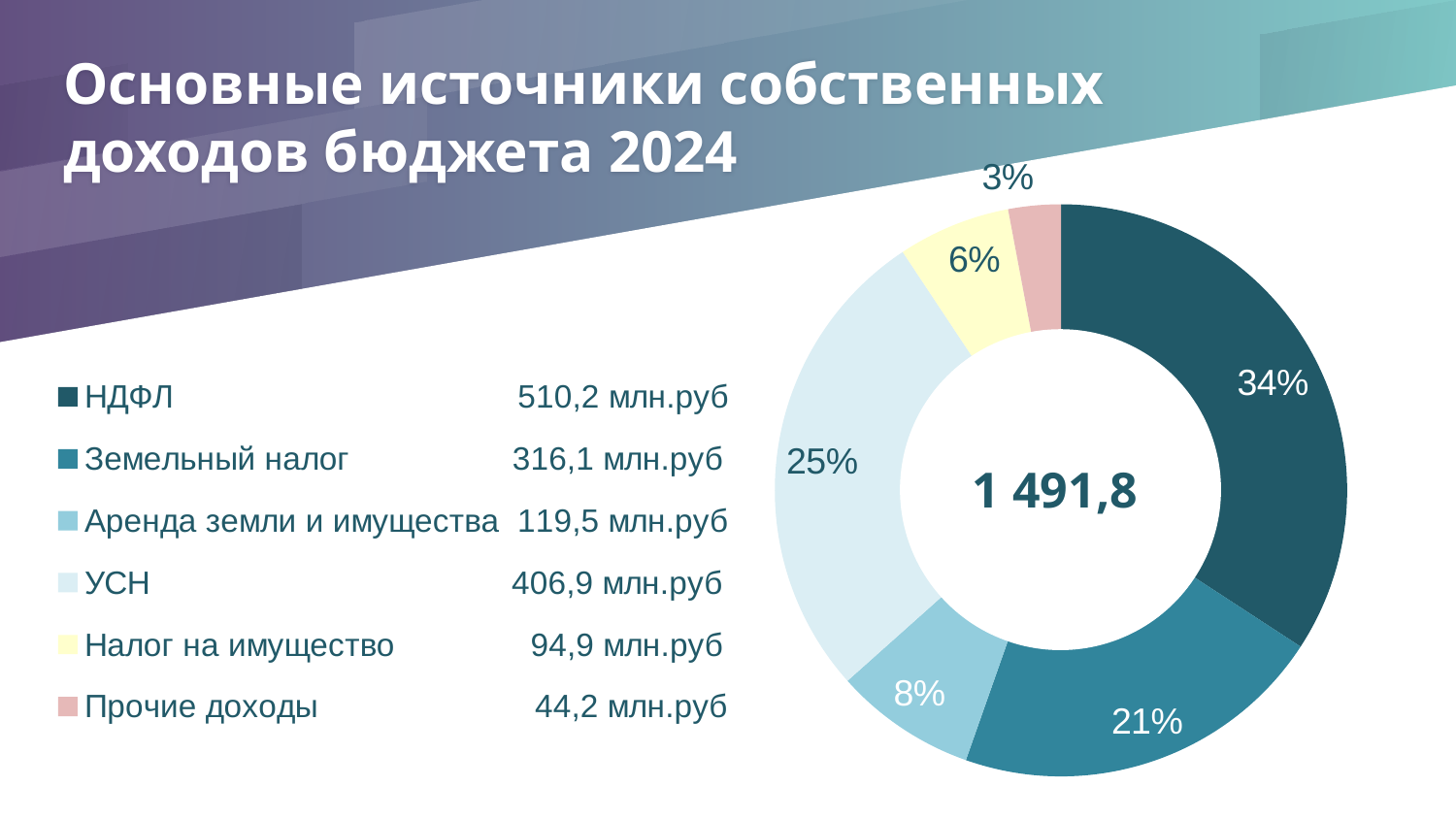
What percentage share of the chart does УСН have? 25% Which is larger, УСН or Земельный налог? УСН What percentage share of the chart does Аренда земли и имущества have? 8% Which category has the largest value? НДФЛ What is the value for Налог на имущество? 94,9 млн.руб How many categories are shown in the chart? 6 What is the difference between the values for НДФЛ and Земельный налог? 194,1 млн.руб Which category has the smallest value? Прочие доходы What total value is shown in the centre of the chart? 1 491,8 What kind of chart is shown on the slide? pie chart What is the value for НДФЛ? 510,2 млн.руб What is the title of the slide? Основные источники собственных доходов бюджета 2024